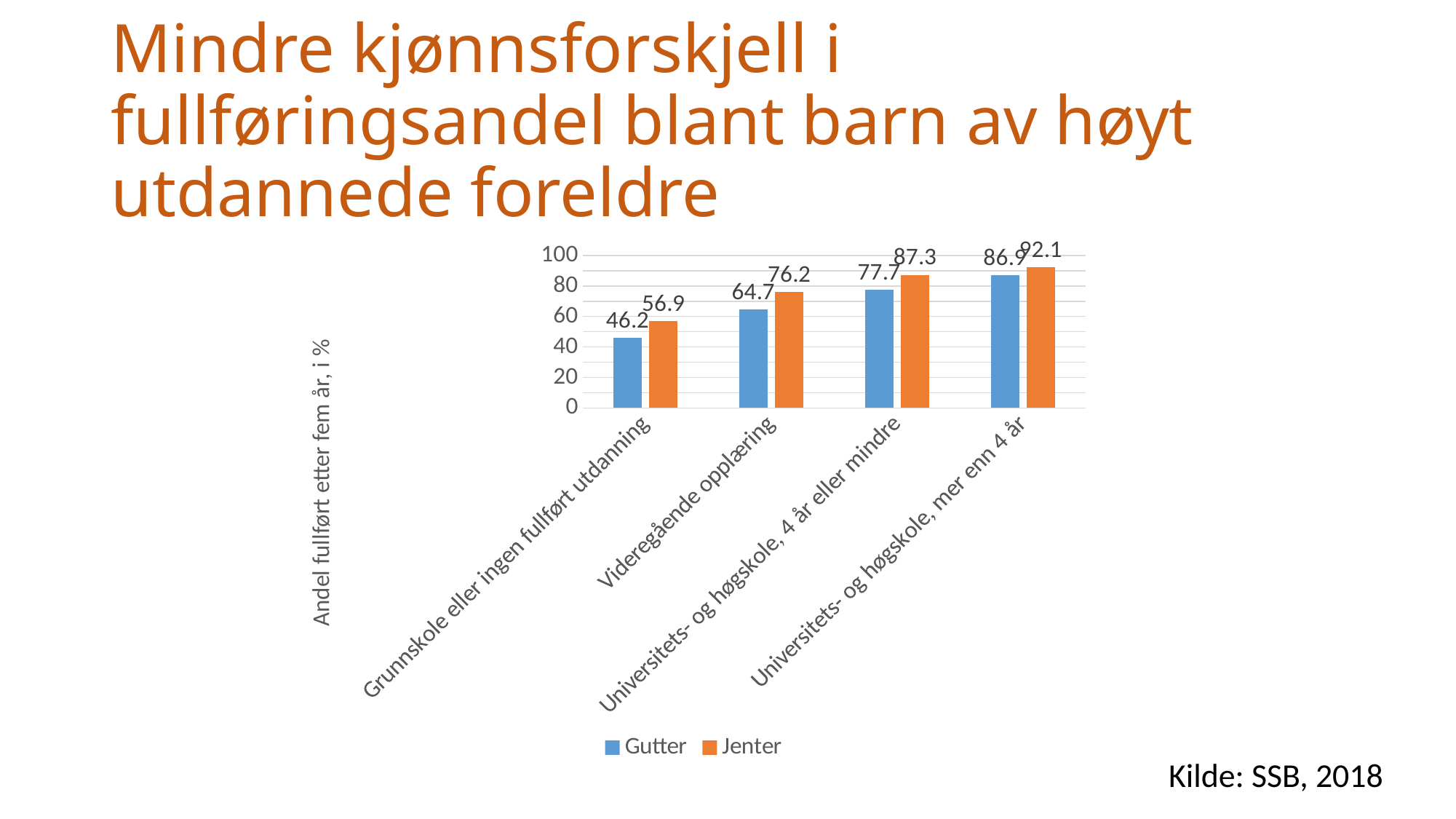
Which category has the lowest value for Gutter? Grunnskole eller ingen fullført utdanning What kind of chart is shown on the slide? Bar chart What is the value for Jenter in the Videregående opplæring category? 76.2 Which is larger in the Videregående opplæring category, Gutter or Jenter? Jenter What is the value for Gutter in the Universitets- og høgskole, 4 år eller mindre category? 77.7 How many categories are shown on the x axis? 4 Which category has the highest value for Jenter? Universitets- og høgskole, mer enn 4 år What is the difference between Jenter and Gutter in the Universitets- og høgskole, mer enn 4 år category? 5.2 What is the difference between Jenter and Gutter in the Grunnskole eller ingen fullført utdanning category? 10.7 What is the value for Jenter in the Universitets- og høgskole, mer enn 4 år category? 92.1 How many series does the legend list? 2 What is the value for Gutter in the Grunnskole eller ingen fullført utdanning category? 46.2